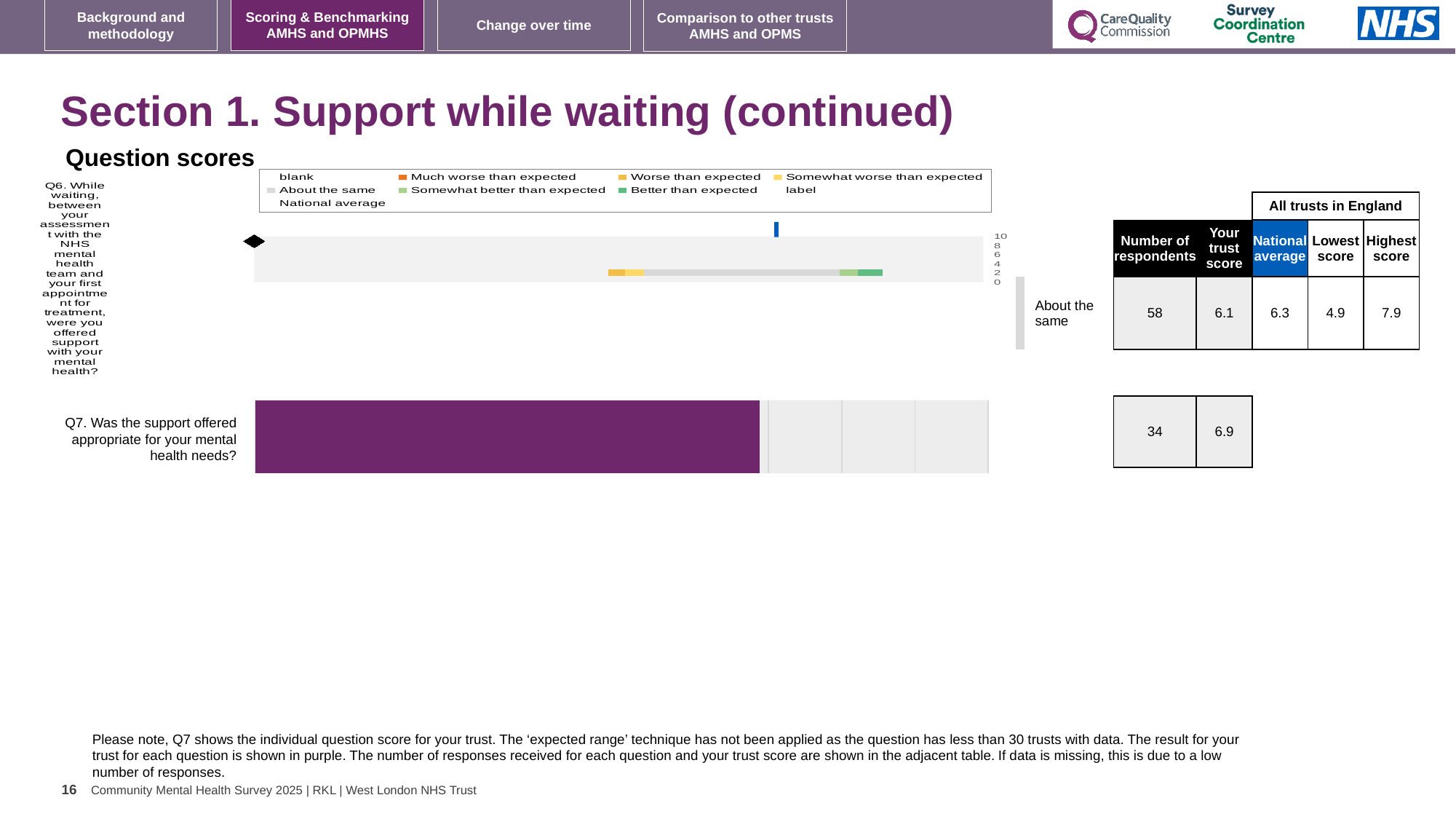
What is the number of respondents for Q7? 34 Is the purple bar for Q7 greater or less than 6 on the axis? greater What is the lowest score across all trusts in England for Q6? 4.9 How many questions are plotted in the Question scores chart? 2 What is the national average for Q6 shown in the table next to the chart? 6.3 What kind of chart is shown under 'Question scores'? bar chart What is the trust score for Q7? 6.9 What is the trust score for Q6 shown in the table next to the chart? 6.1 What is the difference between the highest and lowest scores for Q6? 3.0 Which question has the higher trust score, Q6 or Q7? Q7 What category label is shown next to the Q6 bar in the chart? About the same What is the highest score across all trusts in England for Q6? 7.9